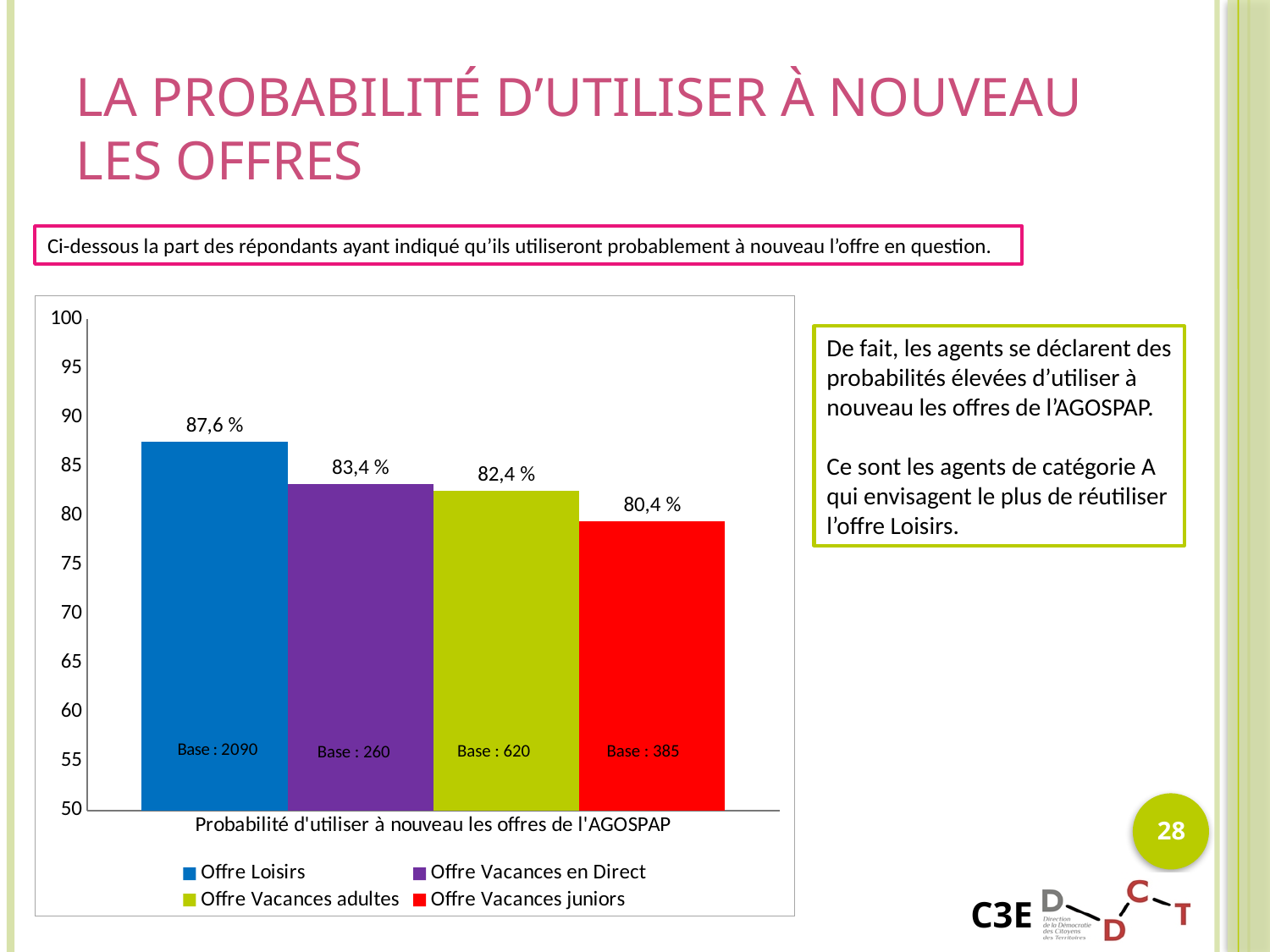
What is the value for Offre Loisirs? 87,6 % How many series does the legend list? 4 What base (number of respondents) is shown on the bar for Offre Loisirs? Base : 2090 Which offer has the highest probability of being used again? Offre Loisirs What is the difference between the values for Offre Loisirs and Offre Vacances juniors? 7,2 % Which offer has the lowest probability of being used again? Offre Vacances juniors What colour is the bar for Offre Vacances juniors? Red What kind of chart is shown on the slide? Bar chart What is the value for Offre Vacances en Direct? 83,4 % Which is larger, the value for Offre Vacances en Direct or Offre Vacances adultes? Offre Vacances en Direct What is the value for Offre Vacances adultes? 82,4 % What is the value for Offre Vacances juniors? 80,4 %